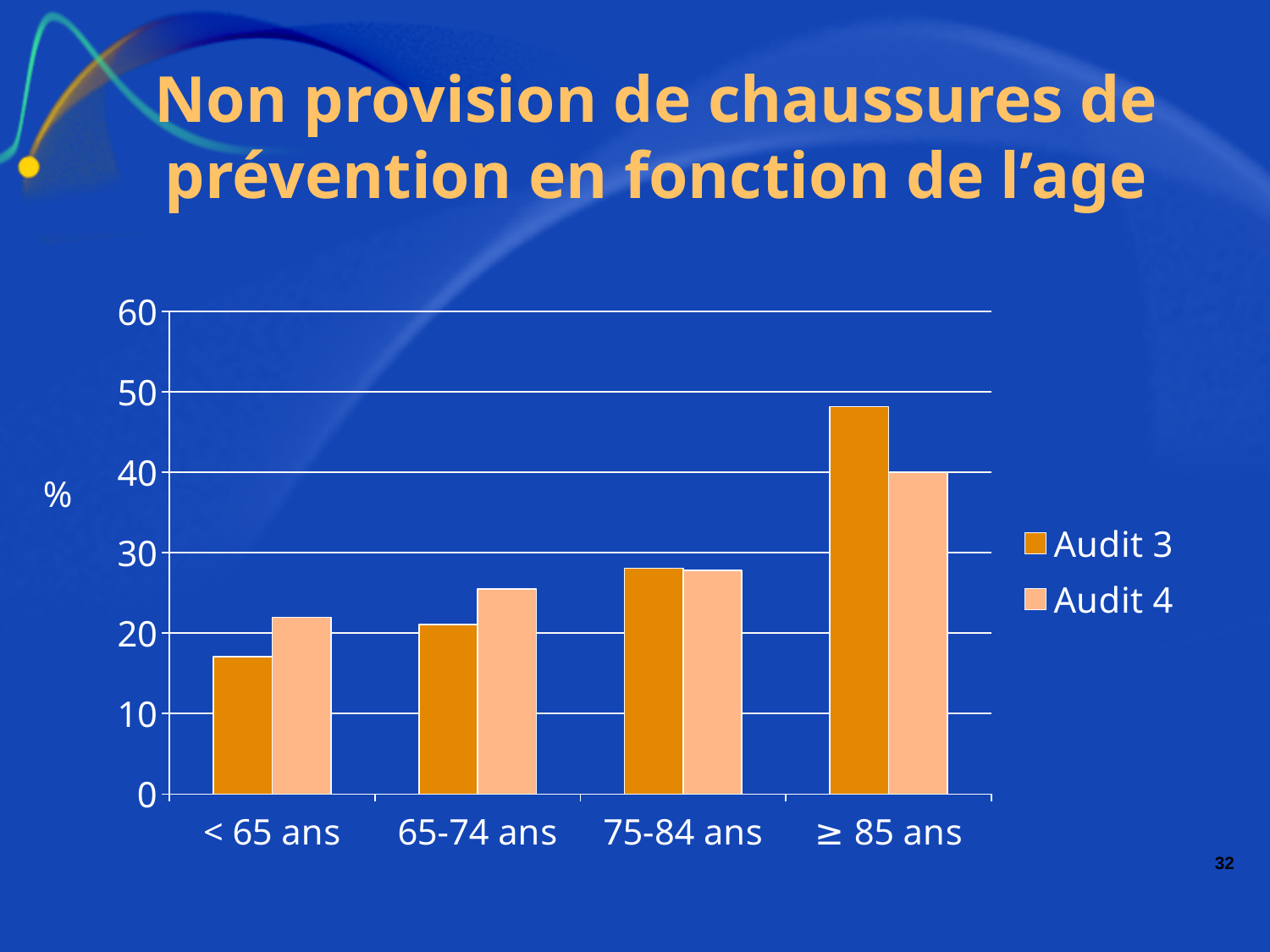
For the < 65 ans category, which is larger, Audit 3 or Audit 4? Audit 4 Which age category has the lowest value for Audit 3? < 65 ans Which age category has the highest value for Audit 4? ≥ 85 ans Is the value for Audit 3 in the ≥ 85 ans category greater or less than 40? greater For the ≥ 85 ans category, which is larger, Audit 3 or Audit 4? Audit 3 Do the Audit 3 values rise or fall as age increases along the x axis? rise How many age categories are shown on the x axis? 4 What kind of chart is shown on the slide? bar chart Which age category has the lowest value for Audit 4? < 65 ans Is the value for Audit 3 in the < 65 ans category greater or less than 20? less Which age category has the highest value for Audit 3? ≥ 85 ans How many series does the legend list? 2